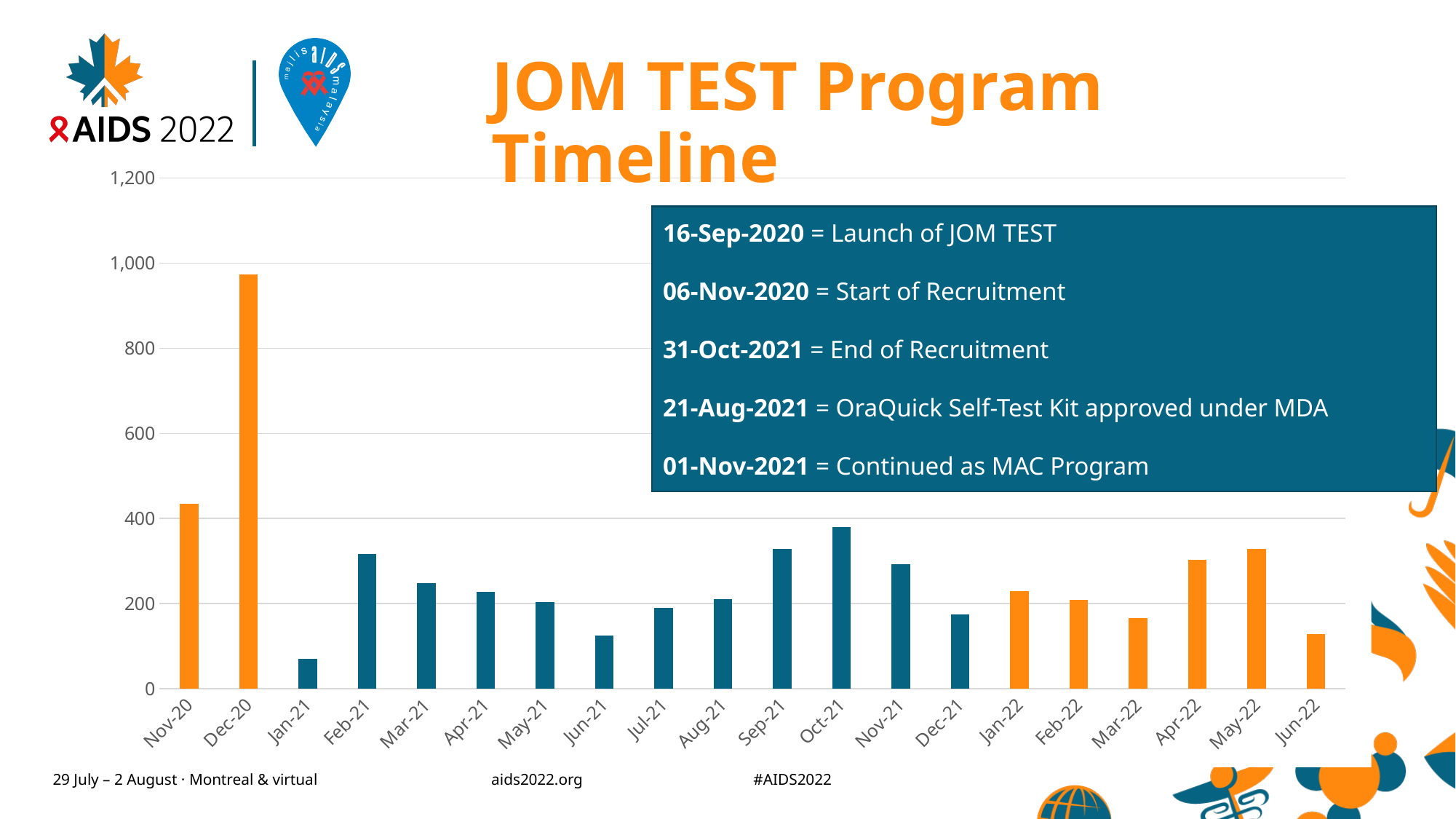
Do the values rise or fall from Feb-21 to Jun-21? fall Which is larger, the value for Jan-21 or the value for Jun-21? Jun-21 Which is larger, the value for Sep-21 or the value for Oct-21? Oct-21 Is the value for Dec-20 greater or less than 800? greater What kind of chart is shown on the slide? Bar chart What is the title of the slide containing the chart? JOM TEST Program Timeline Is the value for Nov-20 greater or less than 400? greater How many months (bars) are plotted on the chart? 20 Is the value for Oct-21 greater or less than 400? less Which month has the highest bar on the chart? Dec-20 Which month has the lowest bar on the chart? Jan-21